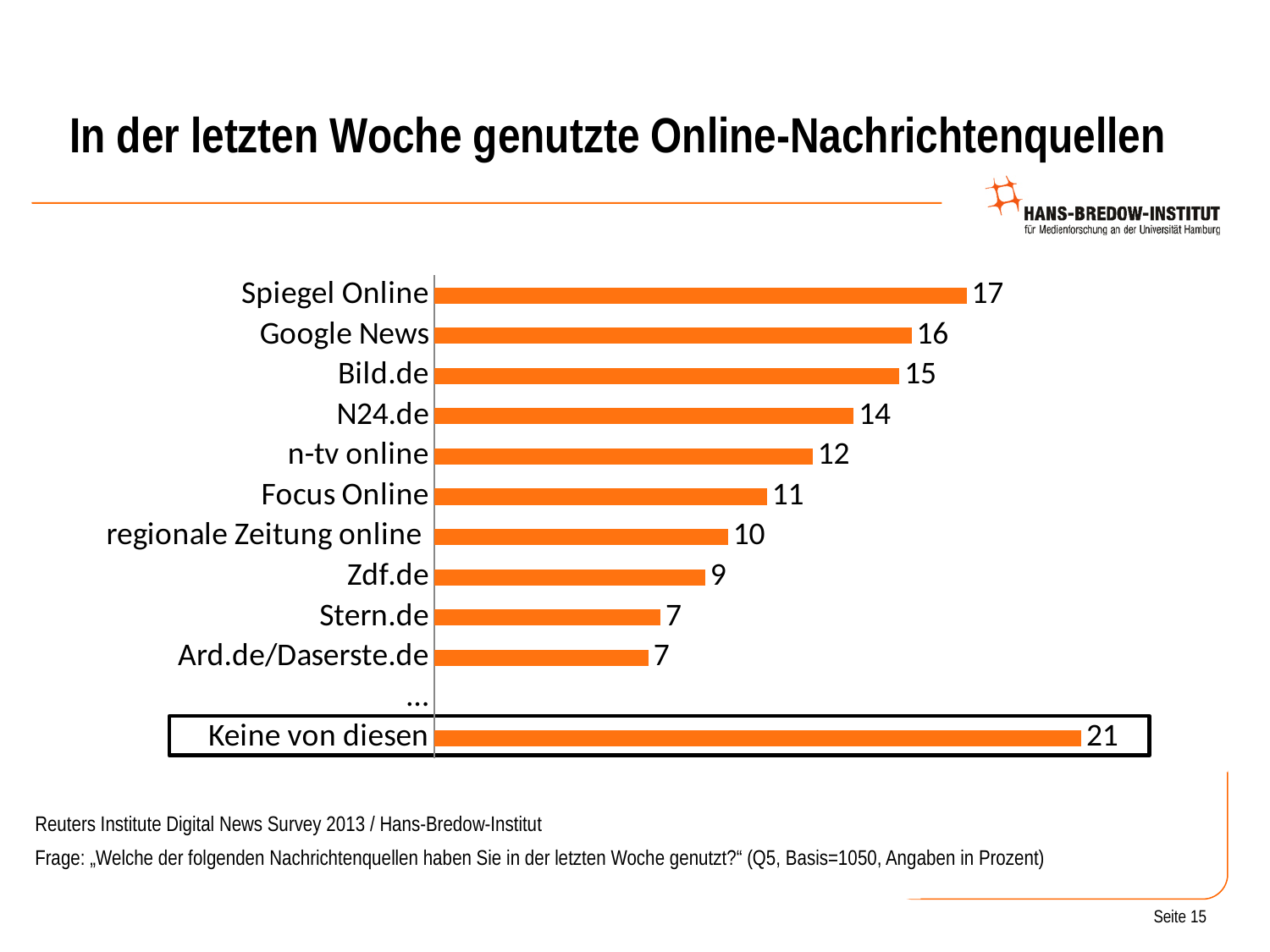
What is the value for Spiegel Online? 17 Which two categories share the lowest value in the chart? Stern.de and Ard.de/Daserste.de What is the difference between the values for Spiegel Online and Zdf.de? 8 Which has a larger value, N24.de or Focus Online? N24.de What kind of chart is shown on the slide? Bar chart What is the difference between the values for Keine von diesen and Spiegel Online? 4 What is the value for Google News? 16 What is the value for Keine von diesen? 21 Which category has the highest value in the chart? Keine von diesen What is the value for regionale Zeitung online? 10 Which of the named online news sources has the highest value? Spiegel Online How many bars are plotted in the chart? 11